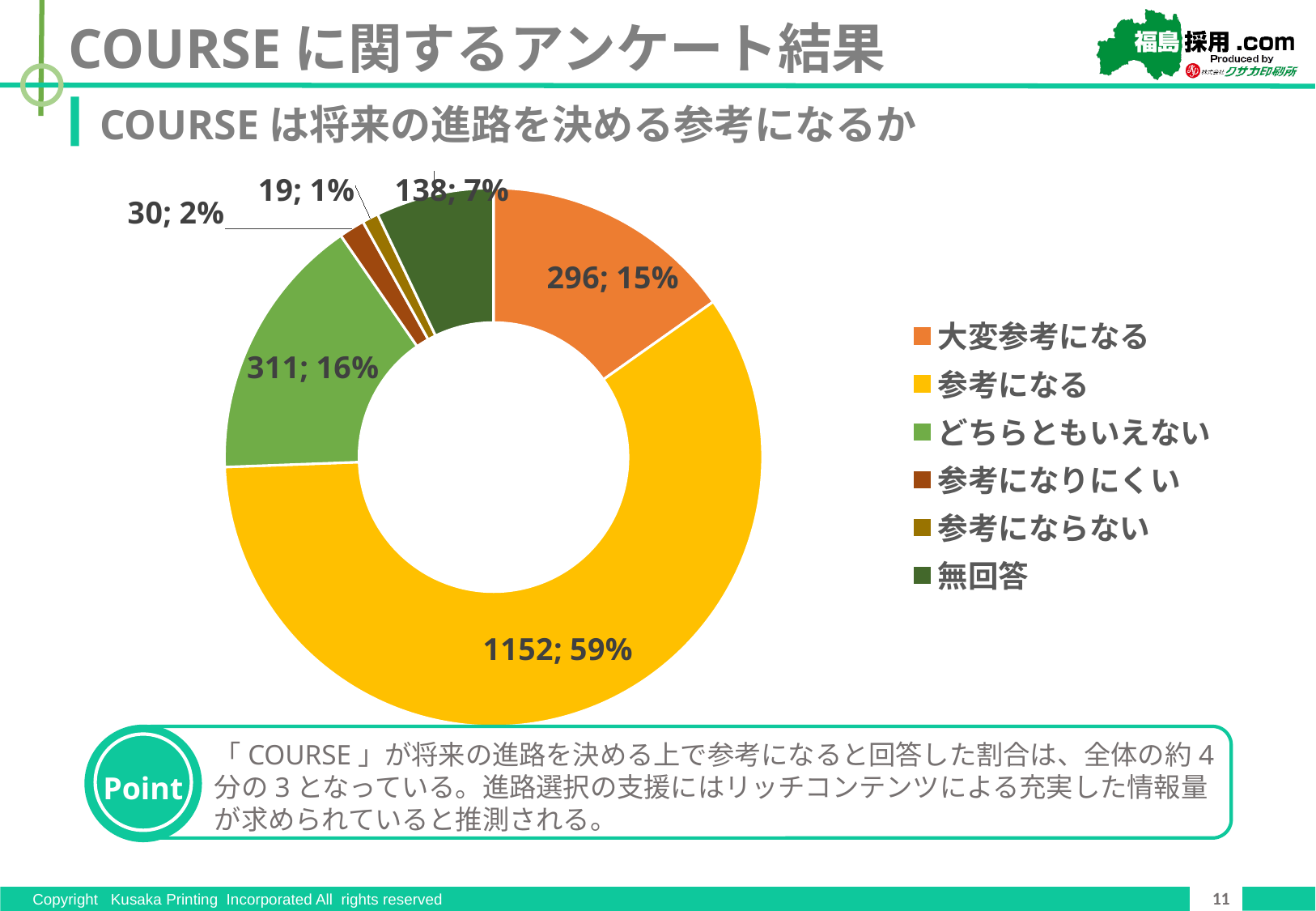
What is the count for どちらともいえない? 311 What percentage is shown for 無回答? 7% What percentage share is shown for 大変参考になる? 15% Which category has the largest slice? 参考になる Which is larger, the count for どちらともいえない or the count for 無回答? どちらともいえない How many categories does the chart show? 6 What is the combined percentage of 大変参考になる and 参考になる? 74% What is the count for 参考になる? 1152 What is the difference in count between 参考になる and 大変参考になる? 856 Which colour represents 参考になりにくい in the legend? Brown What kind of chart is shown on the slide? Pie chart (doughnut) Which category has the smallest slice? 参考にならない